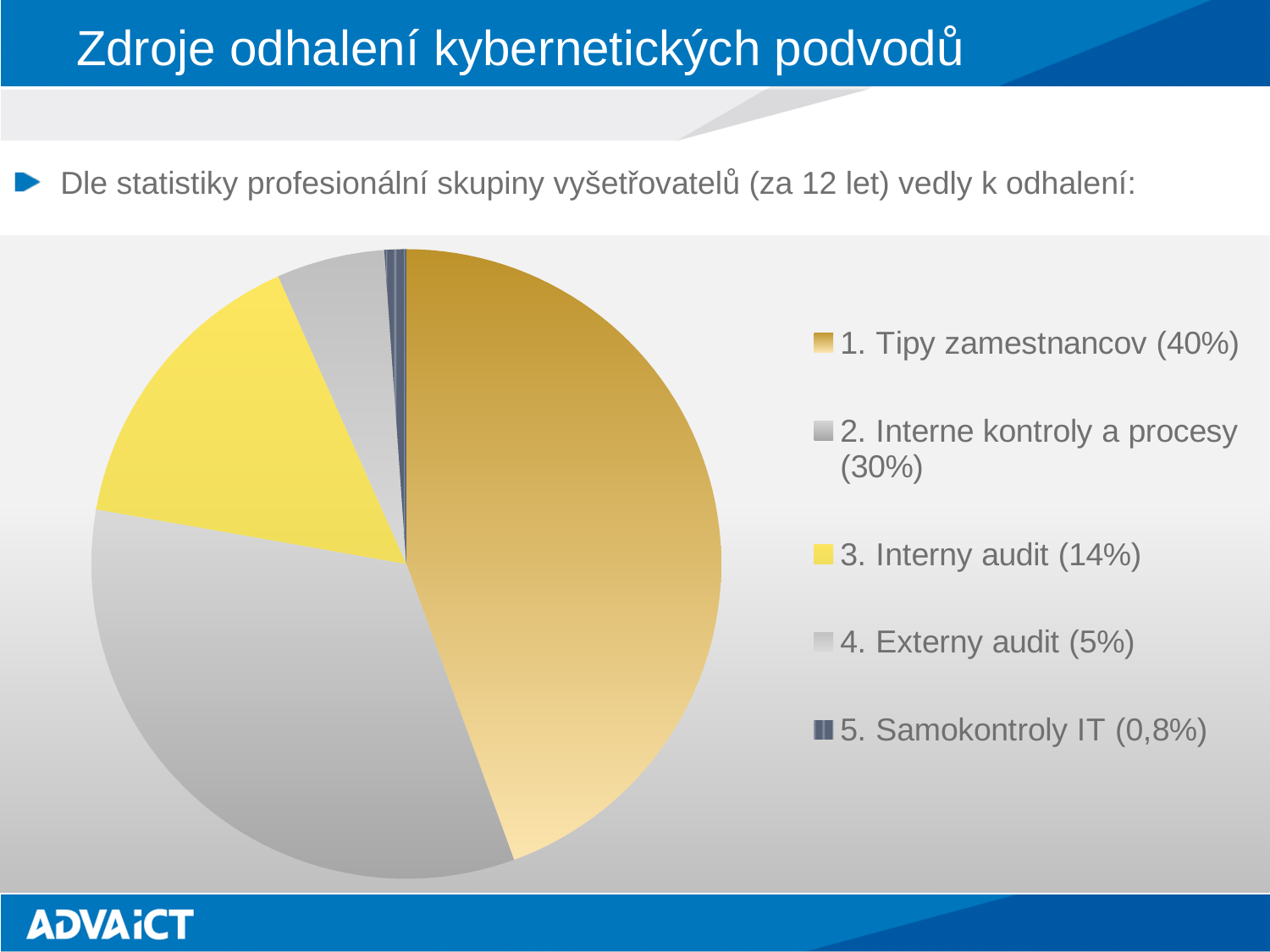
How many slices does the pie chart have? 5 What kind of chart is shown on the slide? pie chart What colour is the slice for "3. Interny audit"? yellow Which category has the smallest slice of the pie? 5. Samokontroly IT Which category has the largest slice of the pie? 1. Tipy zamestnancov What share of the pie does "1. Tipy zamestnancov" have? 40% What is the value for "3. Interny audit"? 14% What share of the pie does "2. Interne kontroly a procesy" have? 30% What is the difference between the shares of "1. Tipy zamestnancov" and "2. Interne kontroly a procesy"? 10% What is the value for "4. Externy audit"? 5% What is the value for "5. Samokontroly IT"? 0,8% Which is larger, the share for "3. Interny audit" or for "4. Externy audit"? 3. Interny audit